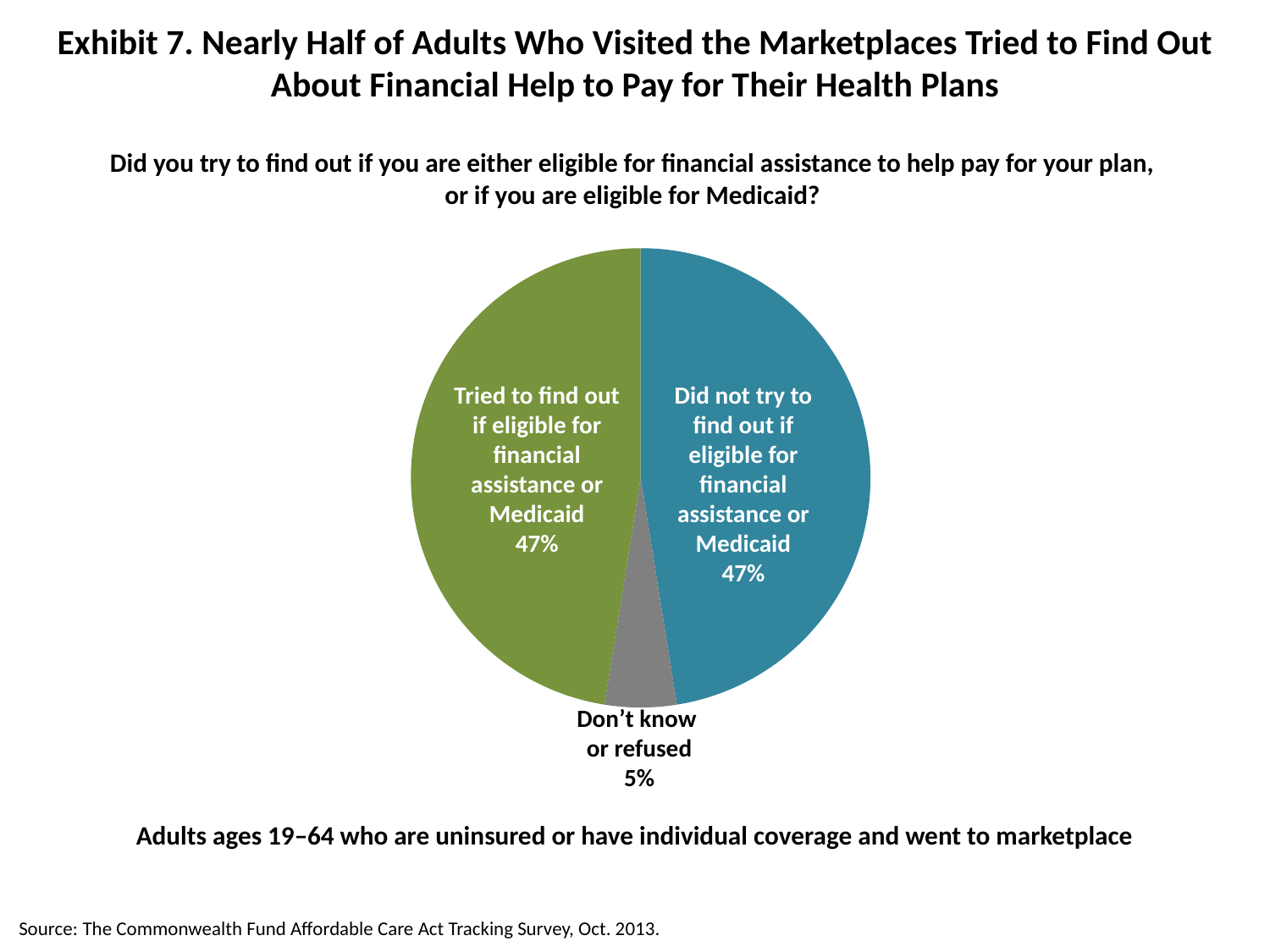
What is the difference in percentage points between the 'Tried to find out' slice and the 'Don't know or refused' slice? 42 What colour is the 'Don't know or refused' slice? gray What colour is the 'Tried to find out if eligible for financial assistance or Medicaid' slice? green What share of adults tried to find out if eligible for financial assistance or Medicaid? 47% What is the combined share of the 'Tried to find out' and 'Did not try to find out' slices? 94% Which is larger: the 'Did not try to find out' slice or the 'Don't know or refused' slice? Did not try to find out if eligible for financial assistance or Medicaid What share of adults did not try to find out if eligible for financial assistance or Medicaid? 47% What share of adults answered 'Don't know or refused'? 5% What kind of chart is shown on the slide? pie chart How many slices does the pie chart have? 3 Which slice of the pie is the smallest? Don't know or refused